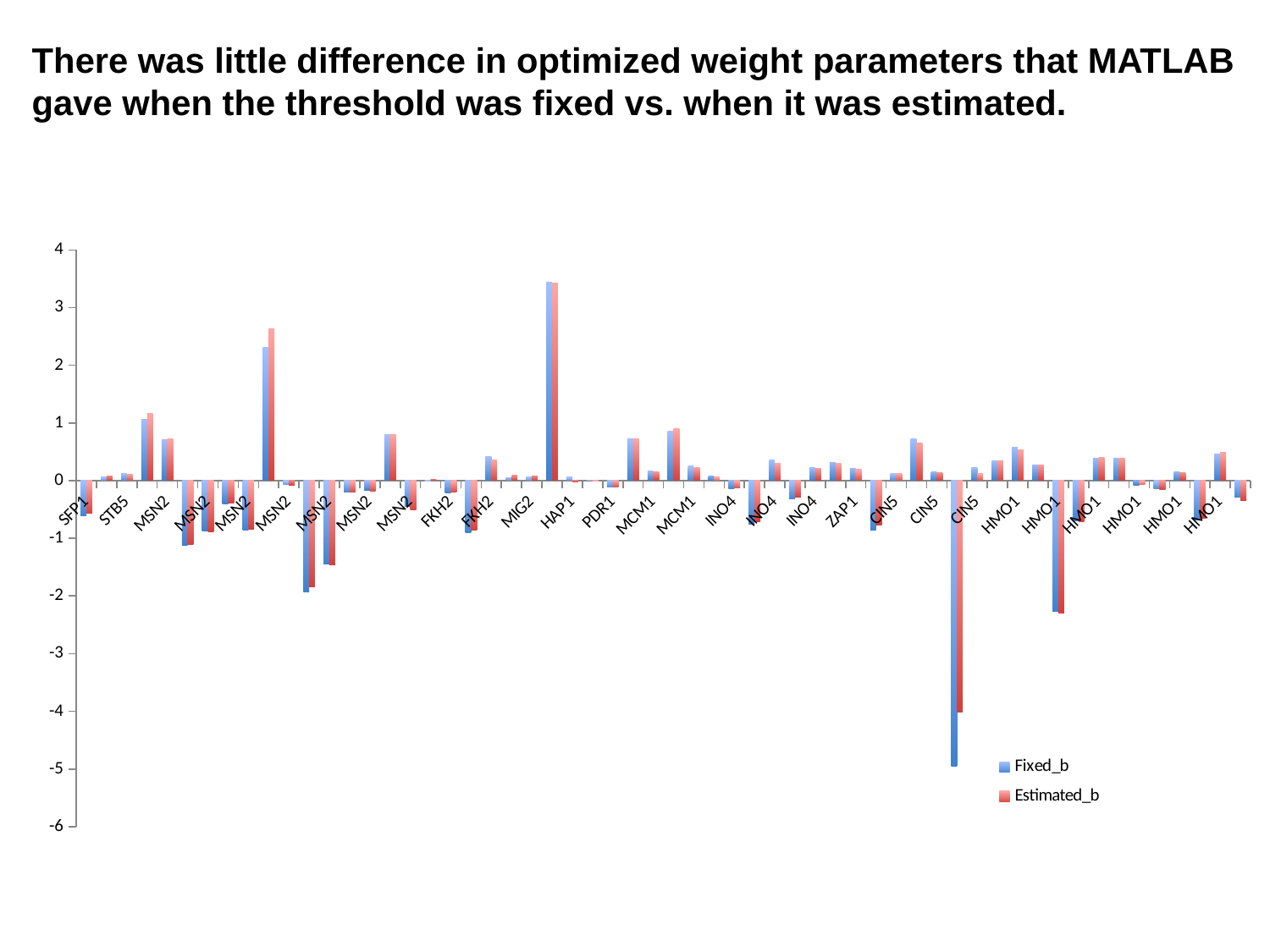
At the CIN5 category with the lowest bars, which series reaches further below zero, Fixed_b or Estimated_b? Fixed_b Is the lowest Fixed_b value (at CIN5) greater or less than -4? less How many series does the legend list? 2 Which category has the highest Estimated_b value? HAP1 Is the Fixed_b value for HAP1 greater or less than 3? greater Which category has the lowest Fixed_b value? CIN5 What is the lowest value shown on the vertical axis? -6 What are the two series named in the legend? Fixed_b and Estimated_b Which colour represents the Estimated_b series? red Which category has the lowest Estimated_b value? CIN5 Which category has the highest Fixed_b value? HAP1 What kind of chart is shown on the slide? bar chart